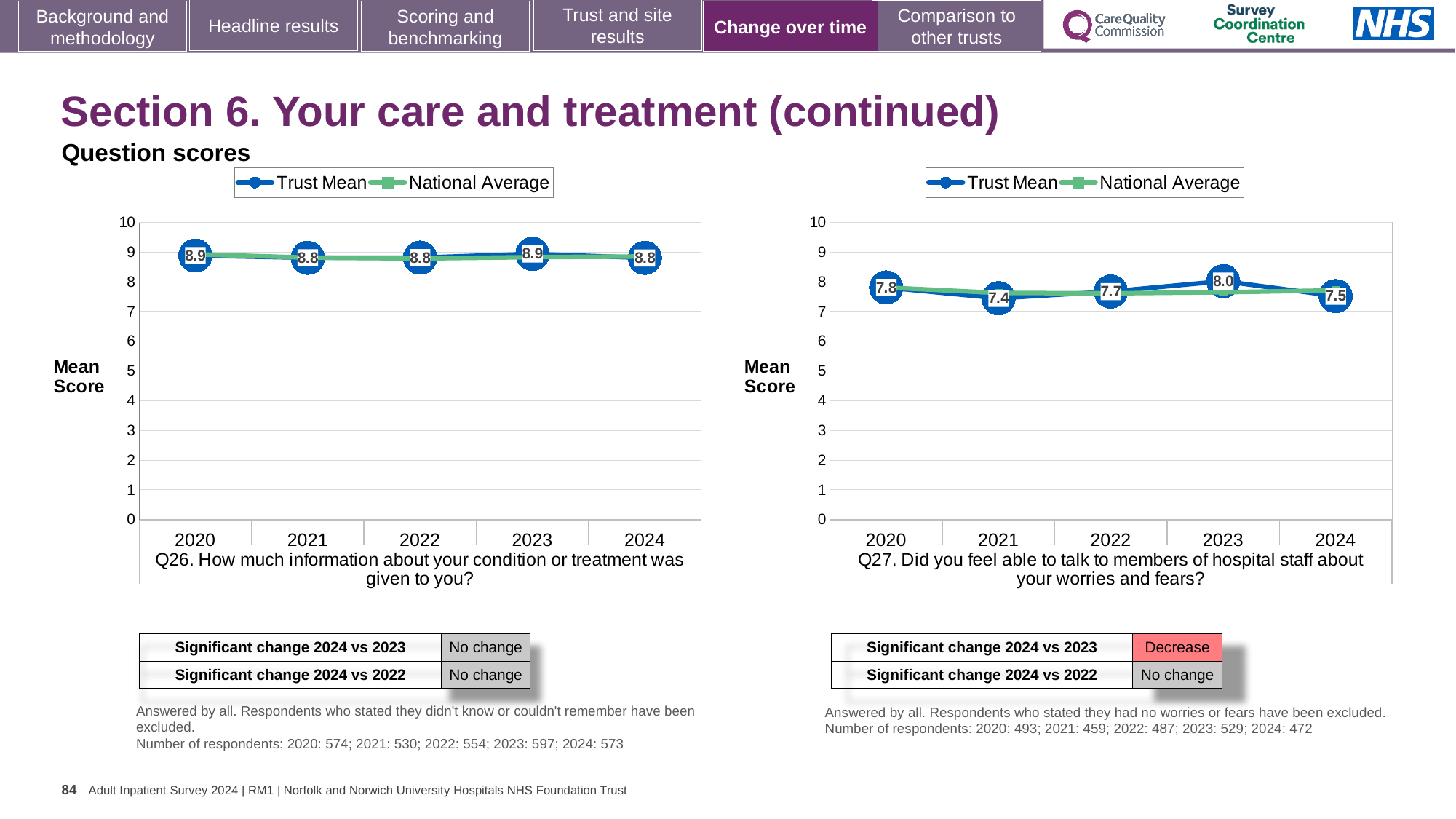
In the Q27 chart on the right, what is the Trust Mean score for 2024? 7.5 In the Q26 chart on the left, is the National Average value for 2022 greater or less than 5? greater In the Q27 chart on the right, which year has the lowest Trust Mean score? 2021 In the Q27 chart on the right, is the Trust Mean score higher in 2022 or in 2024? 2022 In the Q26 chart on the left, what is the Trust Mean score for 2020? 8.9 How many series does the legend of the Q27 chart on the right list? 2 In the Q27 chart on the right, what is the Trust Mean score for 2021? 7.4 What kind of chart is the Q26 chart on the left? Line chart In the Q27 chart on the right, does the Trust Mean score rise or fall from 2023 to 2024? Fall In the Q27 chart on the right, what is the difference between the Trust Mean scores for 2023 and 2021? 0.6 In the Q27 chart on the right, which year has the highest Trust Mean score? 2023 How many years are plotted on the x axis of the Q26 chart on the left? 5